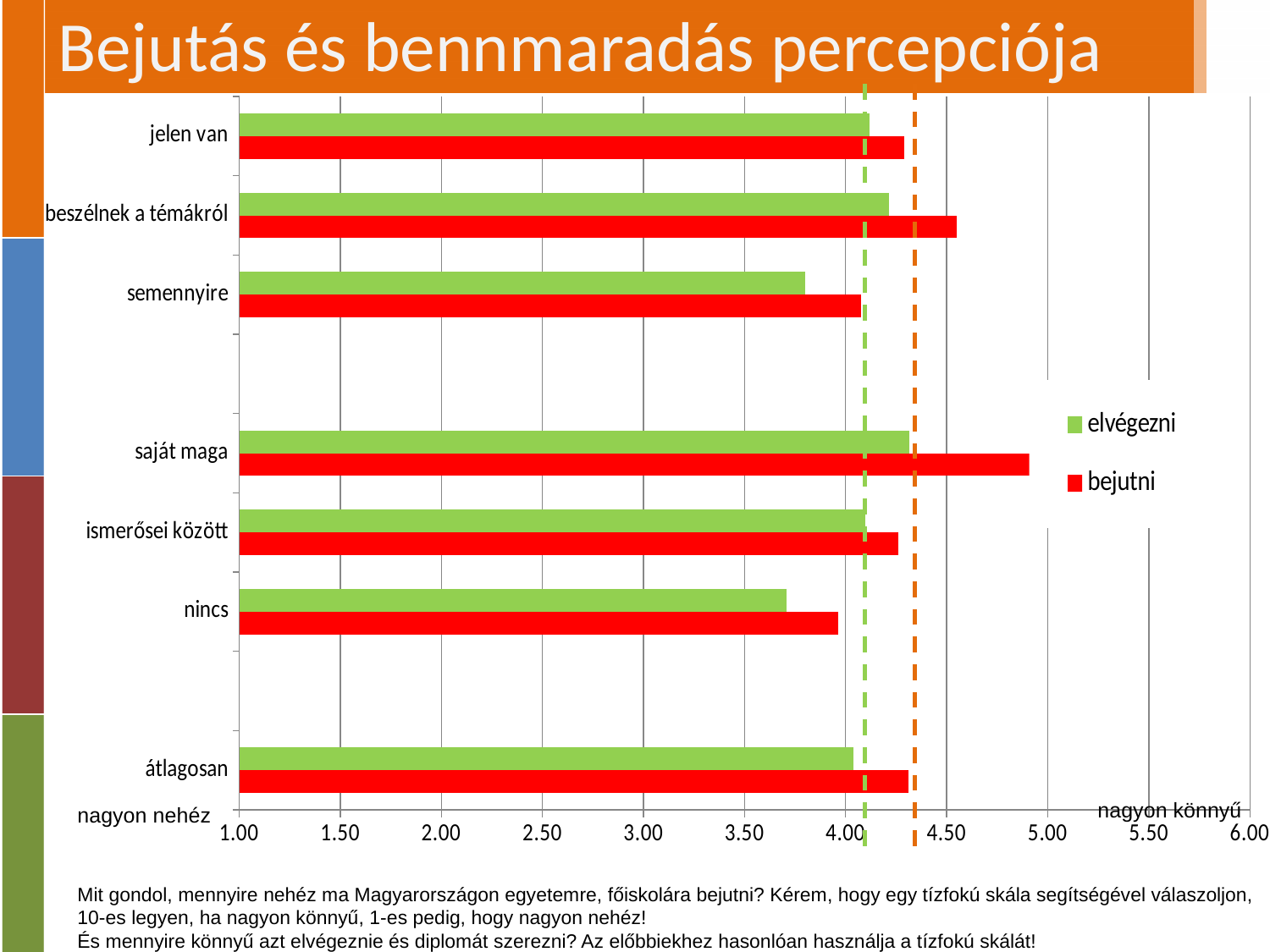
For saját maga, which series has the larger value, elvégezni or bejutni? bejutni How many labelled categories are shown on the vertical axis of the chart? 7 How many series does the legend list? 2 Which category has the highest value for the bejutni series? saját maga Is the bejutni value for jelen van greater or less than 4.00? greater Which colour represents the bejutni series in the chart? red Is the elvégezni value for nincs greater or less than 4.00? less What are the two series named in the legend? elvégezni and bejutni Is the elvégezni value for semennyire greater or less than 4.00? less What kind of chart is shown on the slide? bar chart For the elvégezni series, which is larger: saját maga or nincs? saját maga